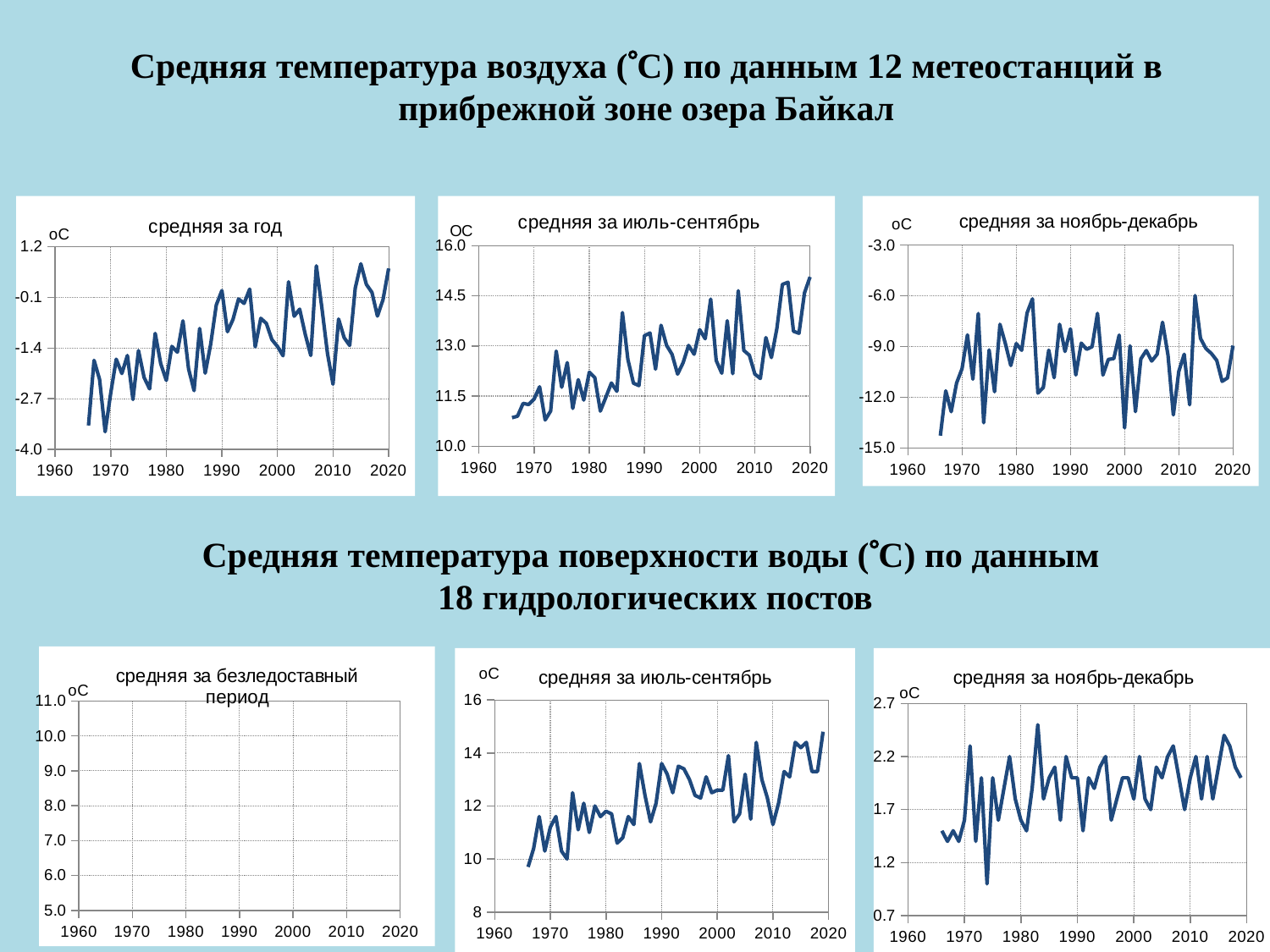
In the top-middle chart "средняя за июль-сентябрь" (air temperature), do the values generally rise or fall over the years? rise In the bottom-middle water temperature chart "средняя за июль-сентябрь", is the value at 2020 greater or less than 14? greater In the bottom-middle water temperature chart "средняя за июль-сентябрь", do the values generally rise or fall over the years? rise What kind of chart is the top-left chart titled "средняя за год"? line chart In the top-right air temperature chart "средняя за ноябрь-декабрь", is the lowest plotted value greater or less than -12.0? less In the top-left chart "средняя за год" (air temperature), do the values generally rise or fall from 1960 to 2020? rise In the top-middle air temperature chart "средняя за июль-сентябрь", which year has the larger value, the first plotted year (mid-1960s) or 2020? 2020 Does the bottom-left chart "средняя за безледоставный период" show any plotted data line? No In the bottom-right water temperature chart "средняя за ноябрь-декабрь", is the highest plotted value greater or less than 2.2? greater How many charts are shown on the slide? 6